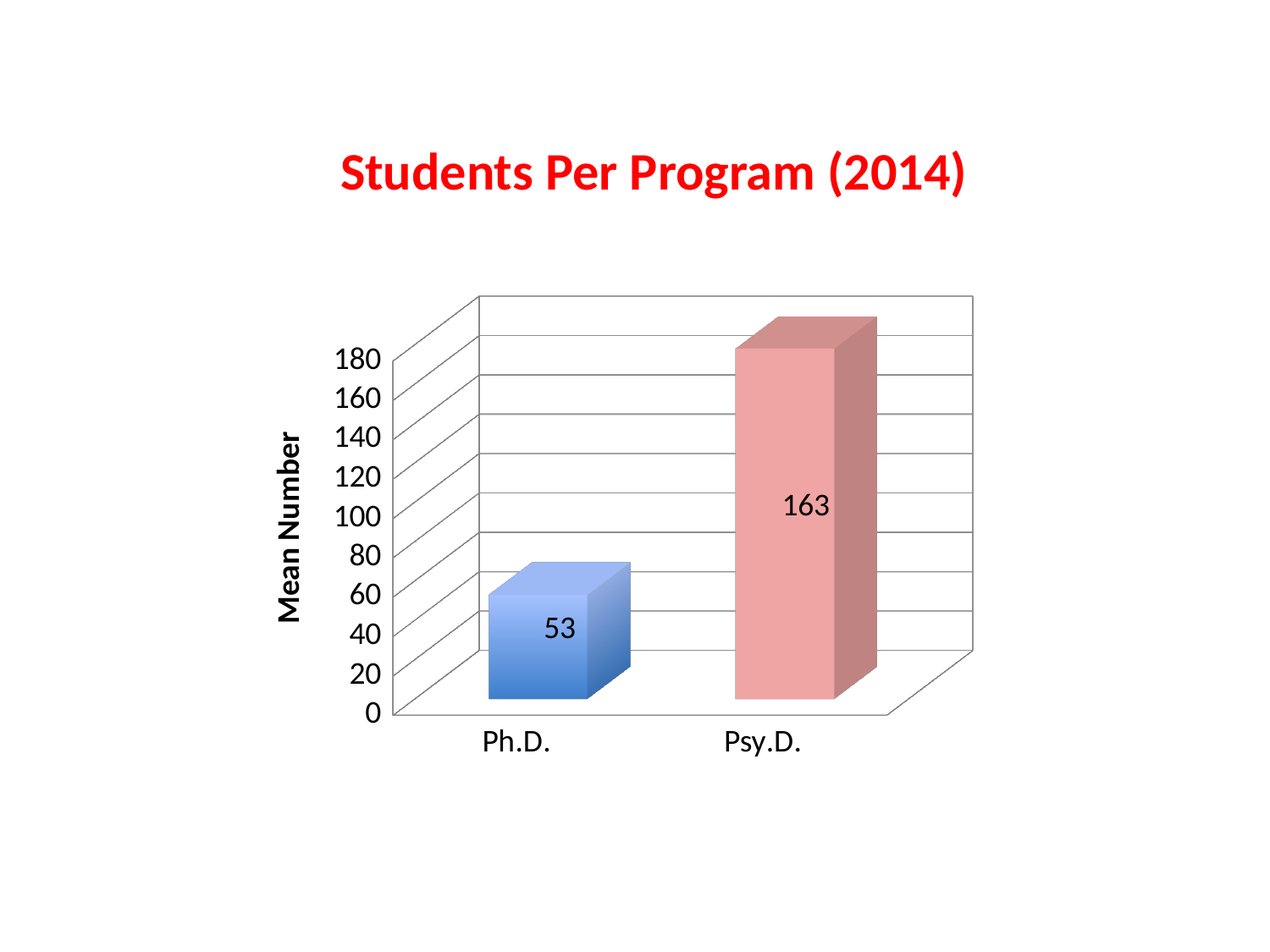
What is the label of the vertical axis? Mean Number What is the difference between the mean number of students in the Psy.D. and Ph.D. programs? 110 Is the value for Ph.D. greater or less than 80? less What kind of chart is shown on the slide? Bar chart What is the mean number of students for the Psy.D. program? 163 What is the mean number of students for the Ph.D. program? 53 What is the title of the chart? Students Per Program (2014) Which program has the highest mean number of students? Psy.D. Is the value for Psy.D. greater or less than 100? greater Which has a larger mean number of students, Ph.D. or Psy.D.? Psy.D. Which program has the lowest mean number of students? Ph.D. How many programs are shown on the chart? 2